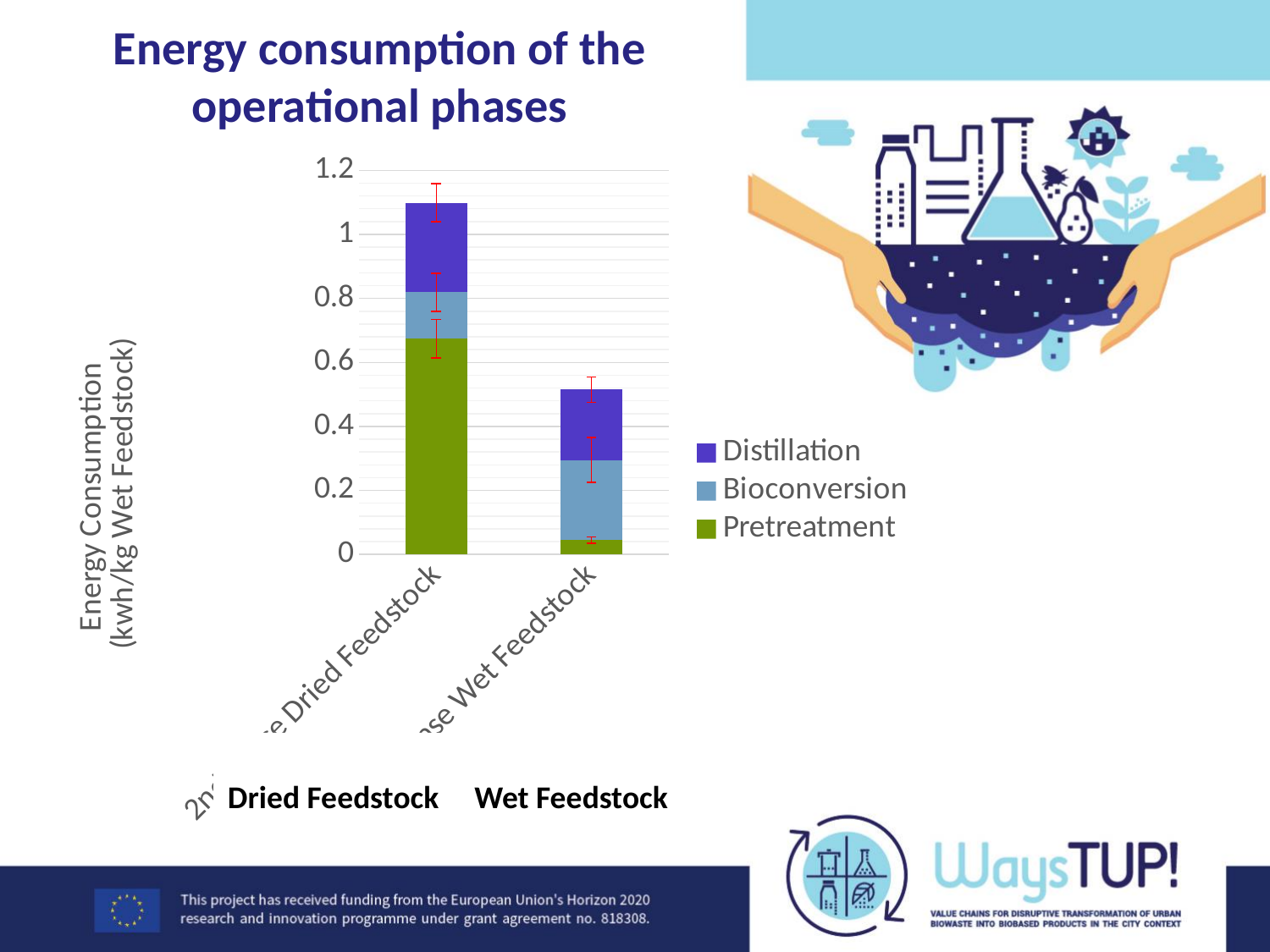
Is the Pretreatment value for Dried Feedstock greater or less than 0.6? greater Is the total energy consumption for Wet Feedstock greater or less than 0.6? less How many feedstock categories are plotted on the x axis? 2 Which feedstock has the higher total energy consumption? Dried Feedstock Which is larger, the Pretreatment segment for Dried Feedstock or the Pretreatment segment for Wet Feedstock? Dried Feedstock How many series does the legend list? 3 What kind of chart is shown on the slide? stacked bar chart Which feedstock has the lower total energy consumption? Wet Feedstock Is the total energy consumption for Dried Feedstock greater or less than 1? greater What unit is given on the y-axis title? kwh/kg Wet Feedstock Which series is shown in green in the legend? Pretreatment